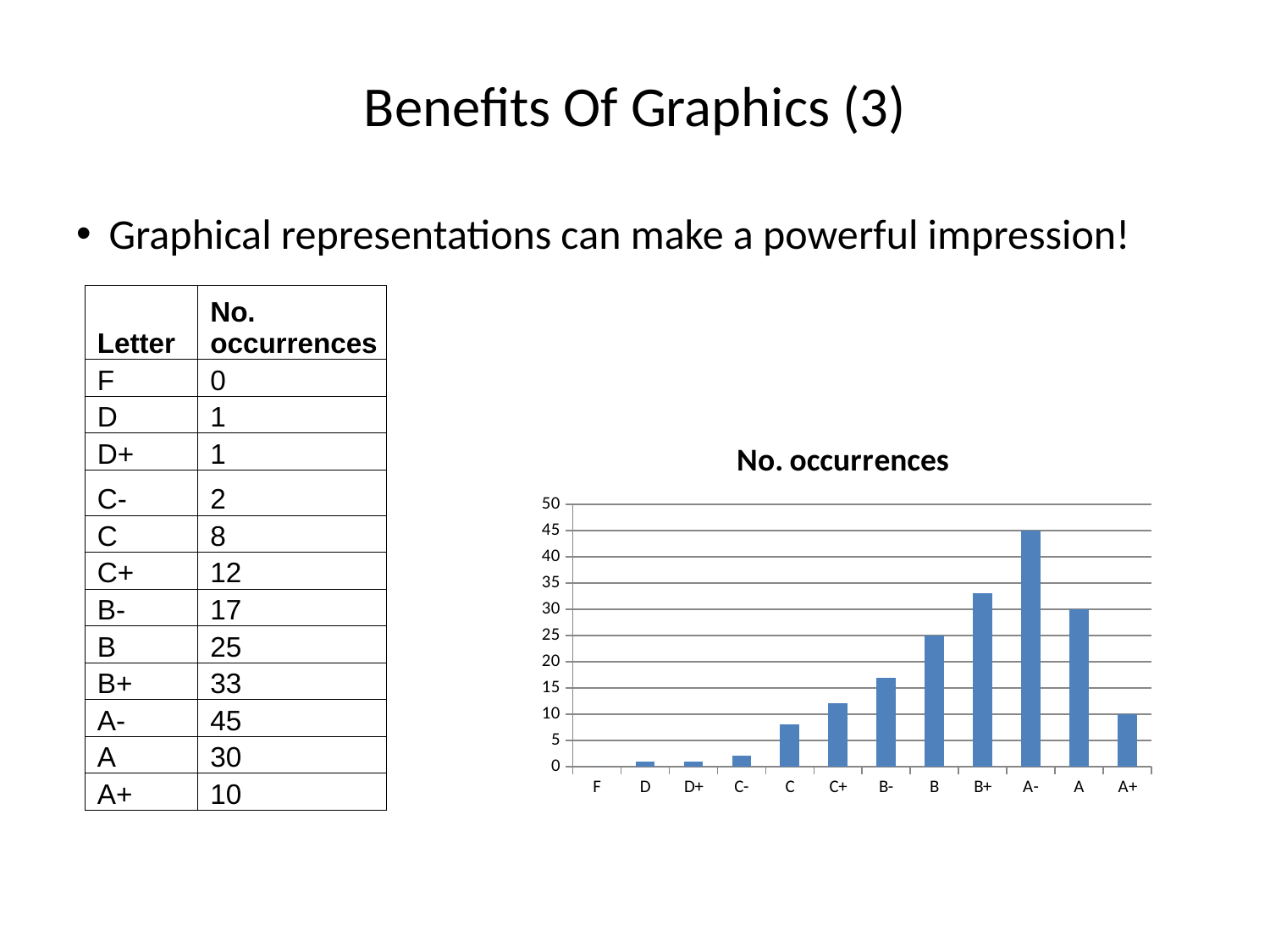
What is the title of the chart? No. occurrences Which letter grade has the lowest number of occurrences in the chart? F What is the number of occurrences for A- according to the slide? 45 What is the number of occurrences for A+ according to the slide? 10 Do the bar values rise or fall from F to A- along the x axis? rise Which letter grade has the highest number of occurrences in the chart? A- Which has more occurrences, B or C+? B What is the number of occurrences for B+ according to the slide? 33 How many letter grade categories are plotted on the x axis of the chart? 12 What is the difference in occurrences between A- and A? 15 What type of chart is shown on the slide? bar chart Is the value for B- greater or less than 20? less